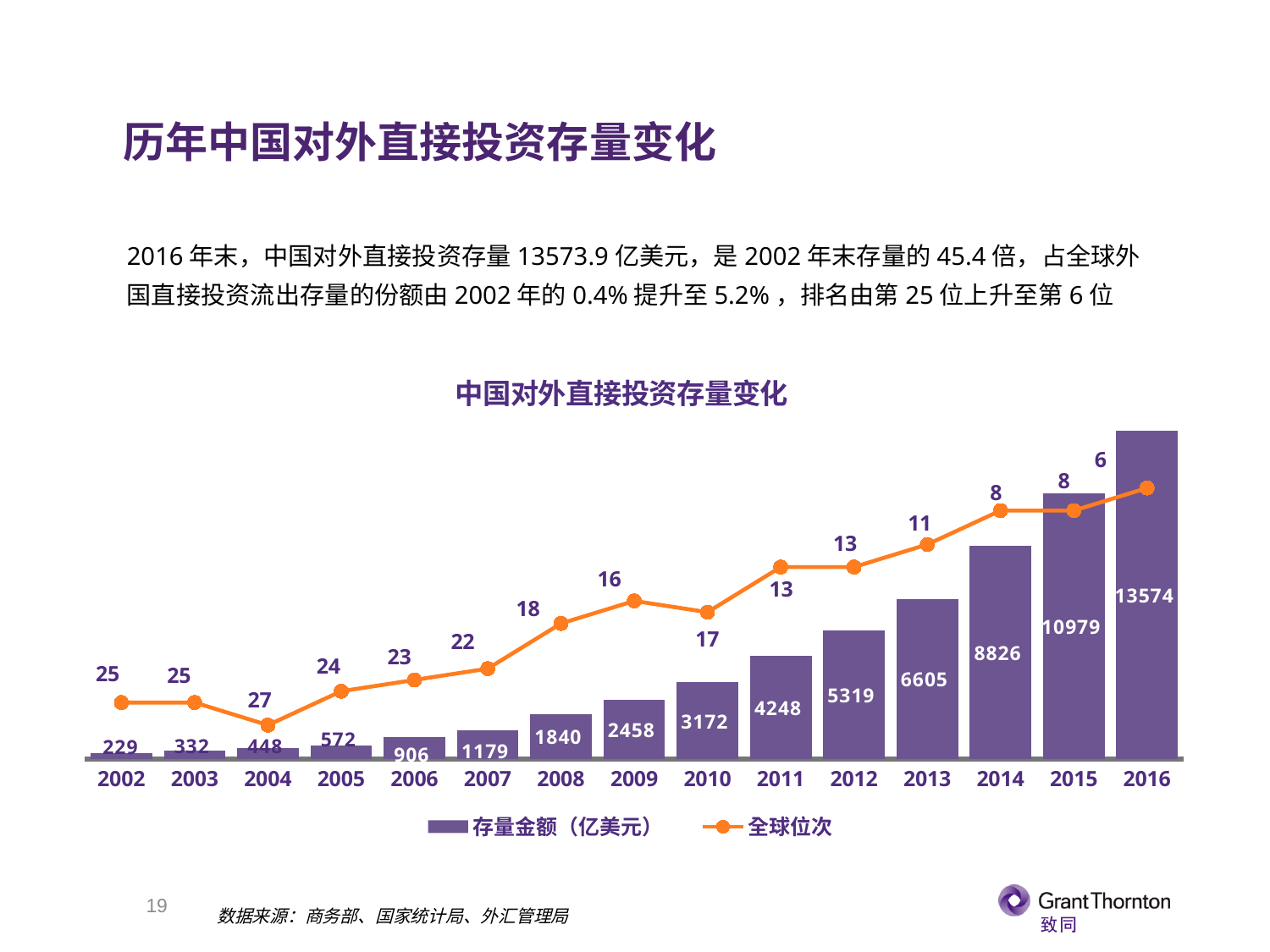
What is the 全球位次 value for 2004? 27 What is the 存量金额 (亿美元) value for 2010? 3172 How many years are shown on the x axis? 15 Which year has the highest 存量金额 (亿美元) value? 2016 Which year has the largest 全球位次 number? 2004 Do the 存量金额 (亿美元) values rise or fall from 2002 to 2016? rise What is the difference between the 存量金额 (亿美元) values for 2016 and 2015? 2595 How many series does the legend list? 2 What is the 存量金额 (亿美元) value for 2016? 13574 Which year has the lowest 存量金额 (亿美元) value? 2002 Which is larger, the 存量金额 (亿美元) value for 2012 or for 2011? 2012 What is the 全球位次 value for 2013? 11